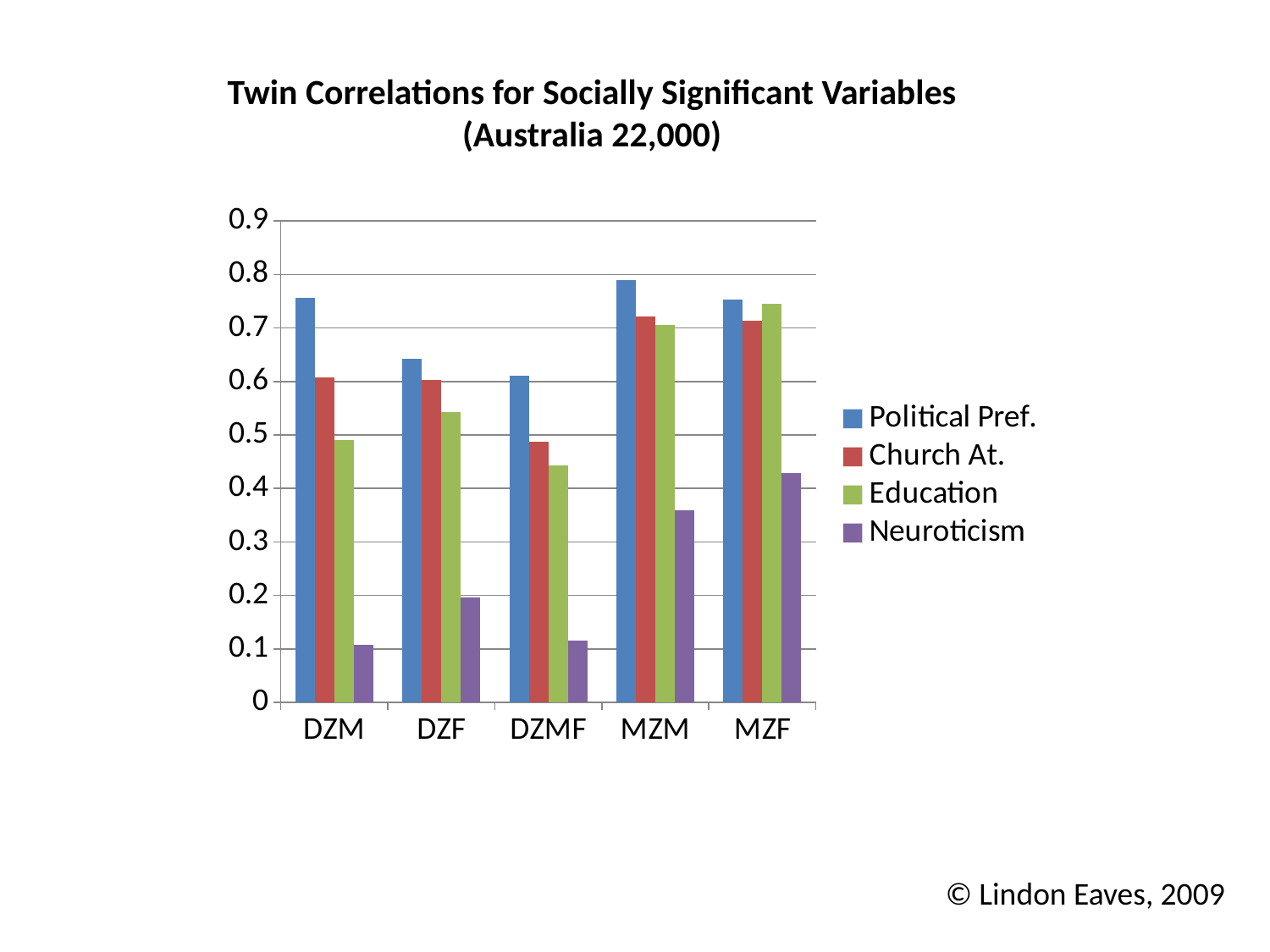
For DZM, which is larger: Political Pref. or Neuroticism? Political Pref. For which twin group is the Political Pref. correlation highest? MZM Is the Political Pref. value for MZM greater or less than 0.7? greater What kind of chart is shown on the slide? bar chart How many series does the legend list? 4 How many twin groups (categories) are shown on the x axis? 5 For which twin group is the Neuroticism correlation highest? MZF Is the Neuroticism value for DZM greater or less than 0.2? less What is the title of the chart? Twin Correlations for Socially Significant Variables (Australia 22,000) Is the Neuroticism value for MZM greater or less than 0.4? less Which group has the larger Political Pref. value, DZM or DZF? DZM For which twin group is the Education correlation lowest? DZMF